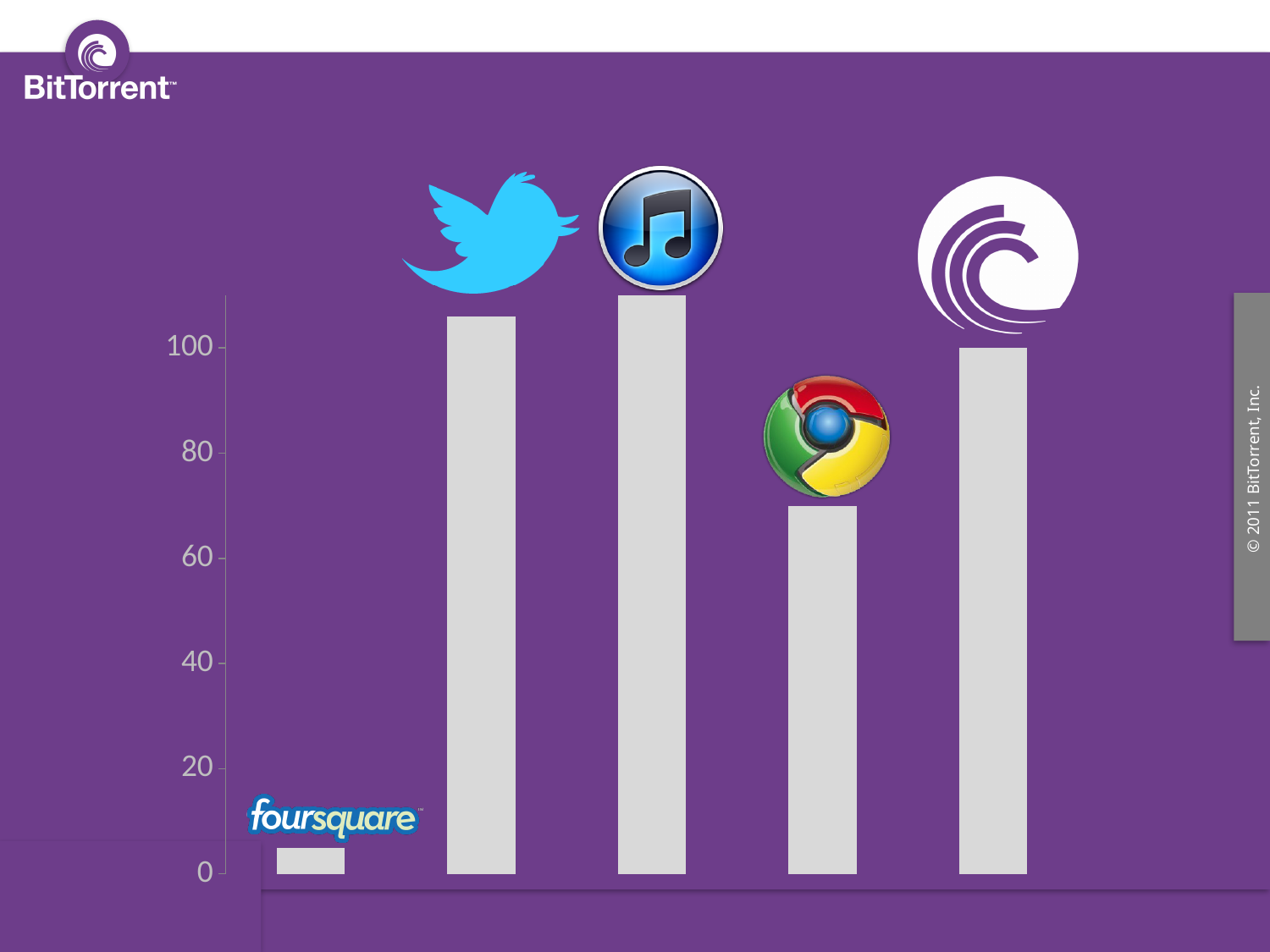
Which is larger, the Chrome bar or the BitTorrent bar? BitTorrent Is the value for the Foursquare bar greater or less than 20? less Which logo sits above the fourth bar from the left? Chrome How many bars does the chart show? 5 Is the value for the Twitter bar greater or less than 100? greater Which bar is the lowest in the chart? Foursquare Which bar is the highest in the chart? iTunes What is the highest value labelled on the vertical axis? 100 Is the value for the Chrome bar greater or less than 60? greater Which is larger, the Foursquare bar or the Chrome bar? Chrome What kind of chart is shown on the slide? bar chart